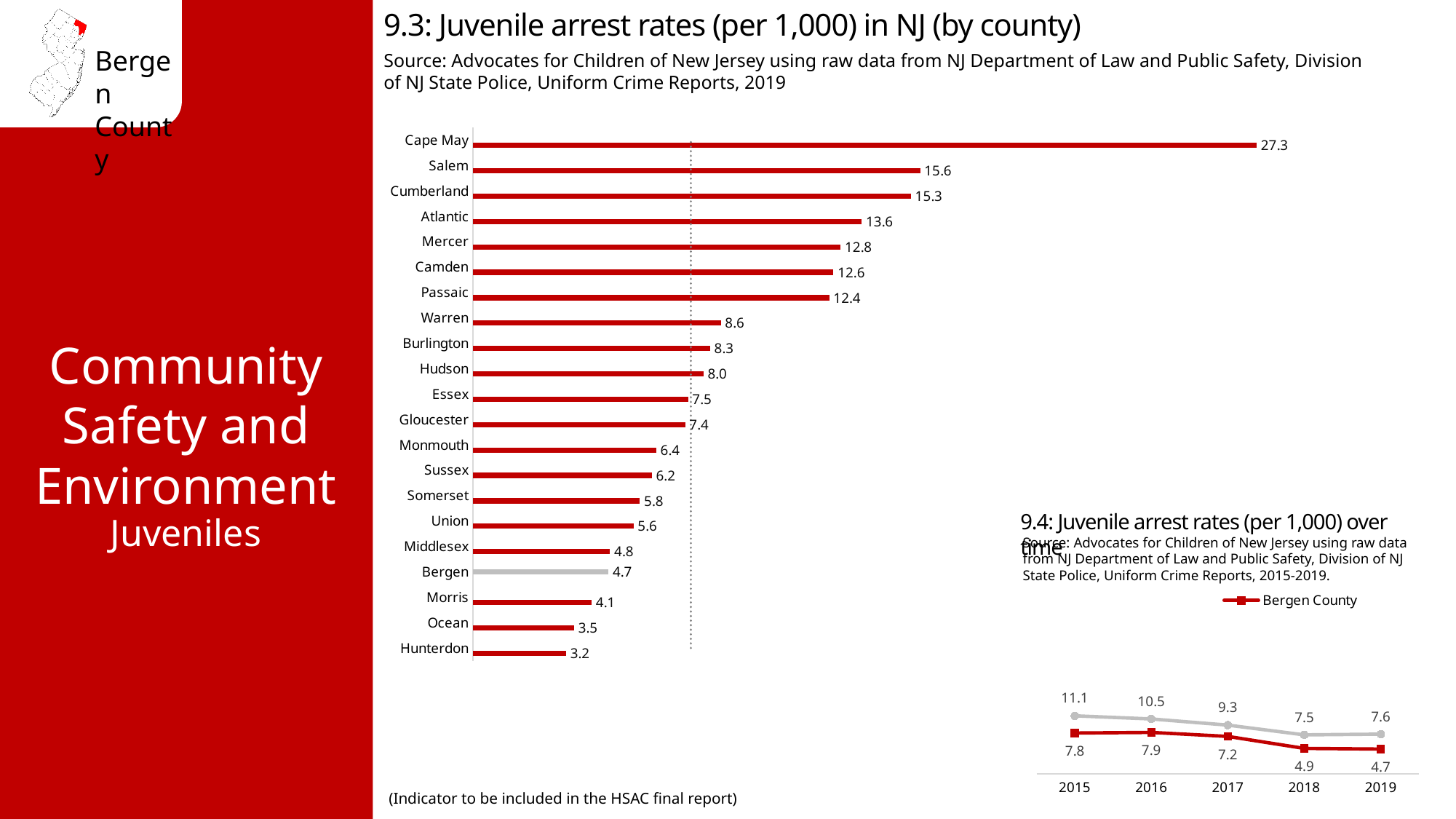
In chart 9.3 (juvenile arrest rates by county), how many counties are shown? 21 In chart 9.4 (juvenile arrest rates over time), what is the difference between the Bergen County values for 2015 and 2019? 3.1 In chart 9.3 (juvenile arrest rates by county), what is the value for Passaic? 12.4 What kind of chart is chart 9.3 (juvenile arrest rates by county)? Bar chart In chart 9.3 (juvenile arrest rates by county), which county has the highest juvenile arrest rate? Cape May In chart 9.4 (juvenile arrest rates over time), what is the Bergen County value for 2018? 4.9 In chart 9.4 (juvenile arrest rates over time), does the Bergen County line generally rise or fall from 2015 to 2019? Fall In chart 9.3 (juvenile arrest rates by county), what is the difference between the values for Cape May and Salem? 11.7 In chart 9.3 (juvenile arrest rates by county), which county has the lowest juvenile arrest rate? Hunterdon In chart 9.3 (juvenile arrest rates by county), which has a higher value, Mercer or Warren? Mercer In chart 9.3 (juvenile arrest rates by county), what is the value for Bergen? 4.7 In chart 9.3 (juvenile arrest rates by county), which county's bar is coloured gray instead of red? Bergen